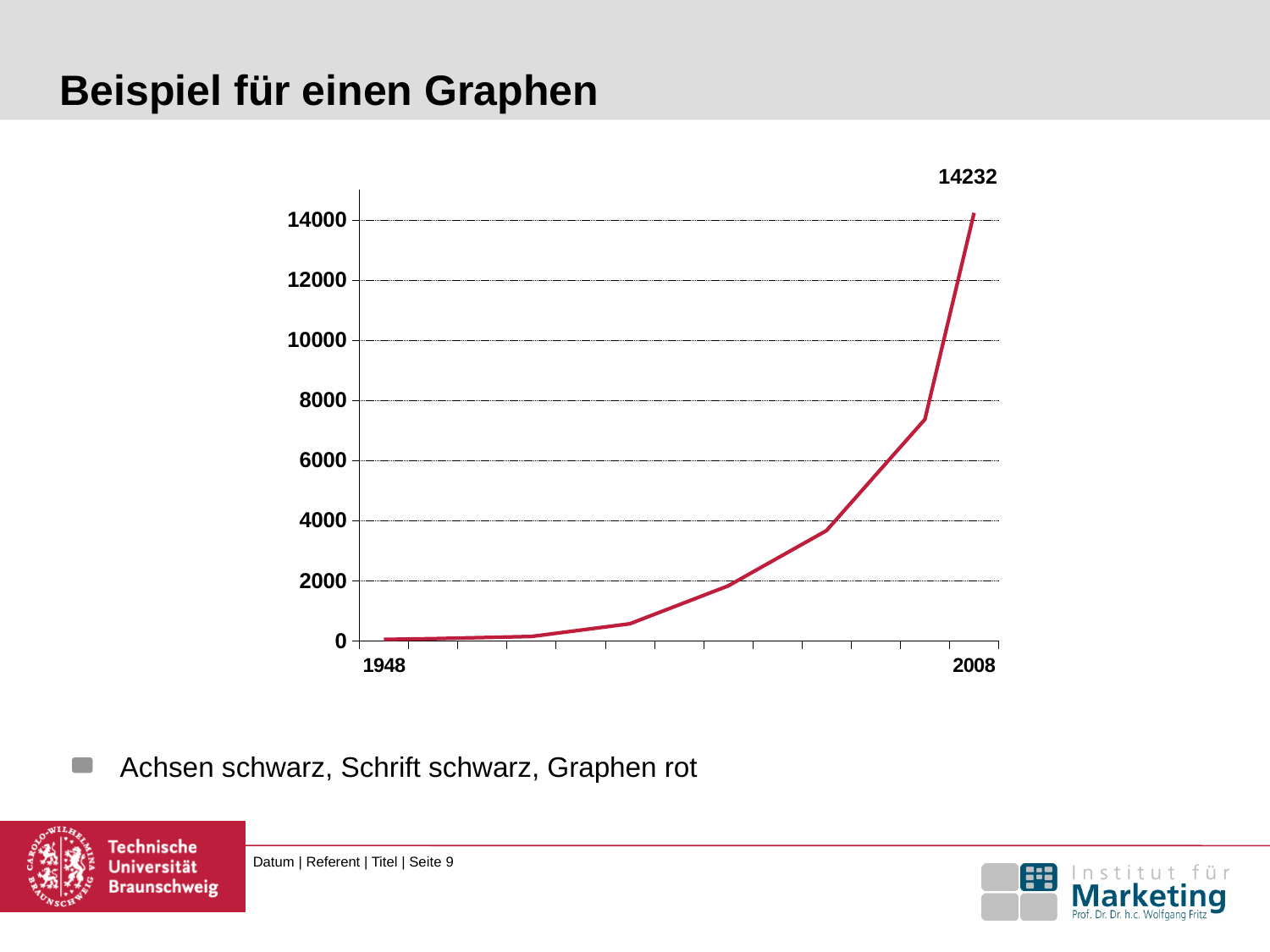
Which year has the highest value on the chart? 2008 Is the value for 1948 greater or less than 2000? less What kind of chart is shown on the slide? line chart Which year has the lowest value on the chart? 1948 Do the values rise or fall from 1948 to 2008? rise Is the value for 2008 greater or less than 12000? greater Is the value for 2008 greater or less than 14000? greater What is the first year shown on the x axis? 1948 What is the highest tick value shown on the y axis? 14000 What value is labelled at the end of the line for 2008? 14232